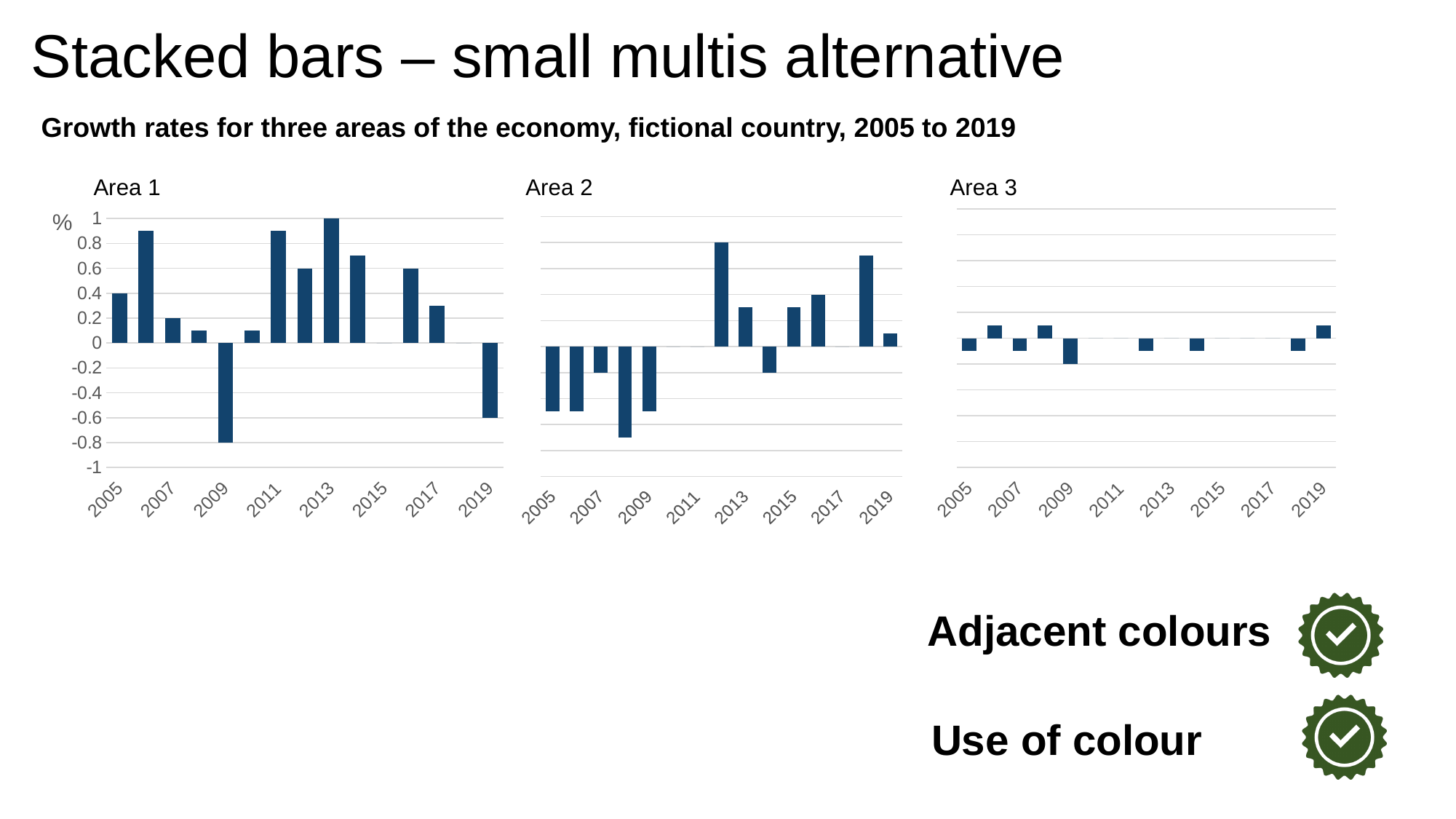
What kind of chart is used for Area 1? bar chart In the Area 2 chart, which year has the highest growth rate? 2012 In the Area 2 chart, is the value for 2012 greater or less than 0.6? greater In the Area 1 chart, what is the growth rate for 2013? 1 In the Area 1 chart, which year has the highest growth rate? 2013 In the Area 1 chart, is the value for 2019 greater or less than -0.4? less In the Area 2 chart, which year has the lowest growth rate? 2008 In the Area 1 chart, which year has the lowest growth rate? 2009 In the Area 1 chart, what is the growth rate for 2009? -0.8 What is the title printed above the three charts? Growth rates for three areas of the economy, fictional country, 2005 to 2019 How many small charts are shown on the slide? 3 In the Area 1 chart, which is larger, the value for 2006 or the value for 2007? 2006